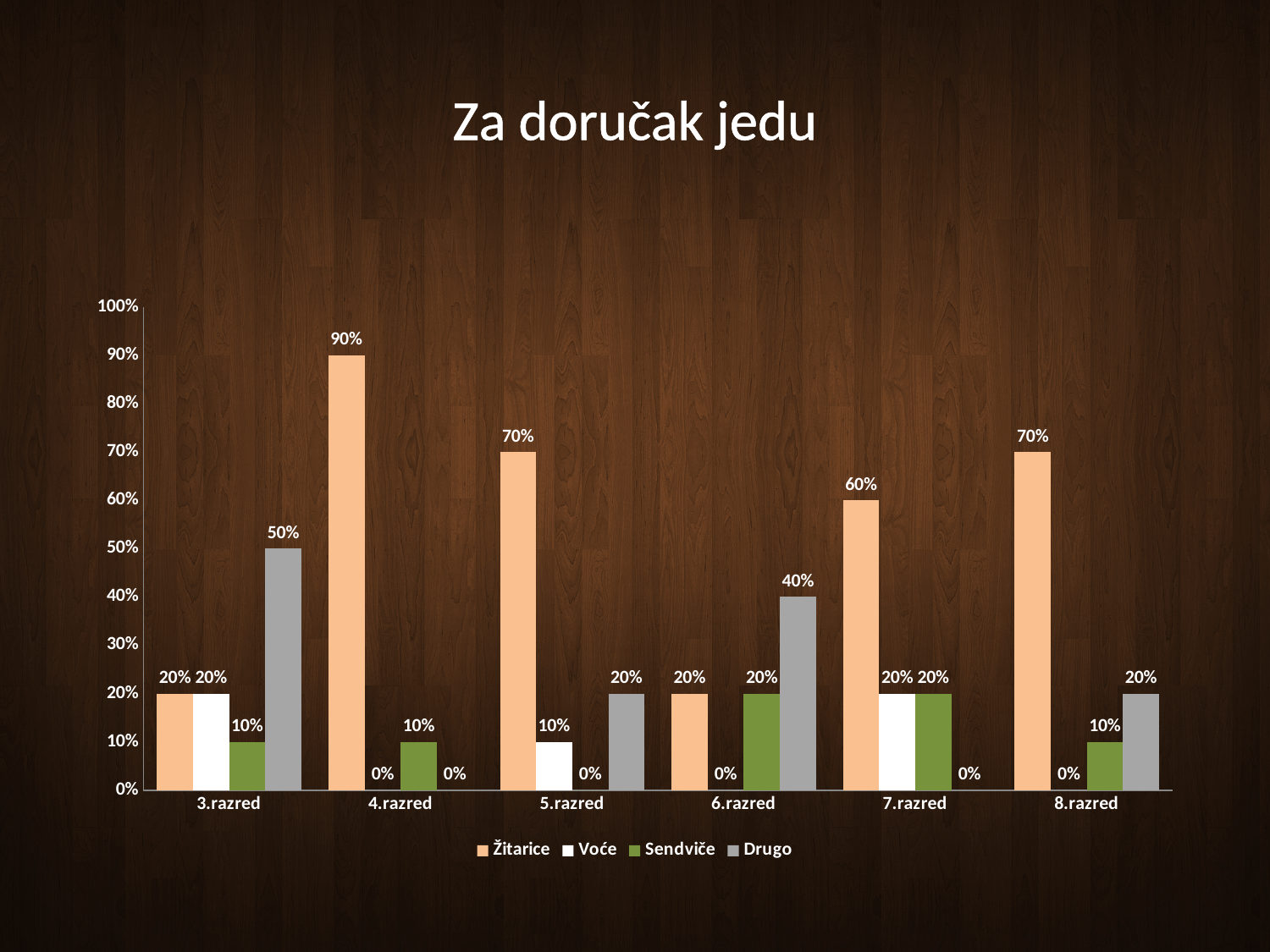
Which is larger: Drugo in 6.razred or Drugo in 8.razred? Drugo in 6.razred What is the value for Voće in 5.razred? 10% Which category has the highest value for Žitarice? 4.razred What kind of chart is shown on the slide? Bar chart How many series does the legend list? 4 What is the value for Drugo in 3.razred? 50% Which category has the highest value for Drugo? 3.razred What is the difference between the Žitarice values for 4.razred and 7.razred? 30% What is the value for Sendviče in 6.razred? 20% What is the value for Žitarice in 4.razred? 90% What is the title of the chart? Za doručak jedu How many categories are shown on the x axis? 6